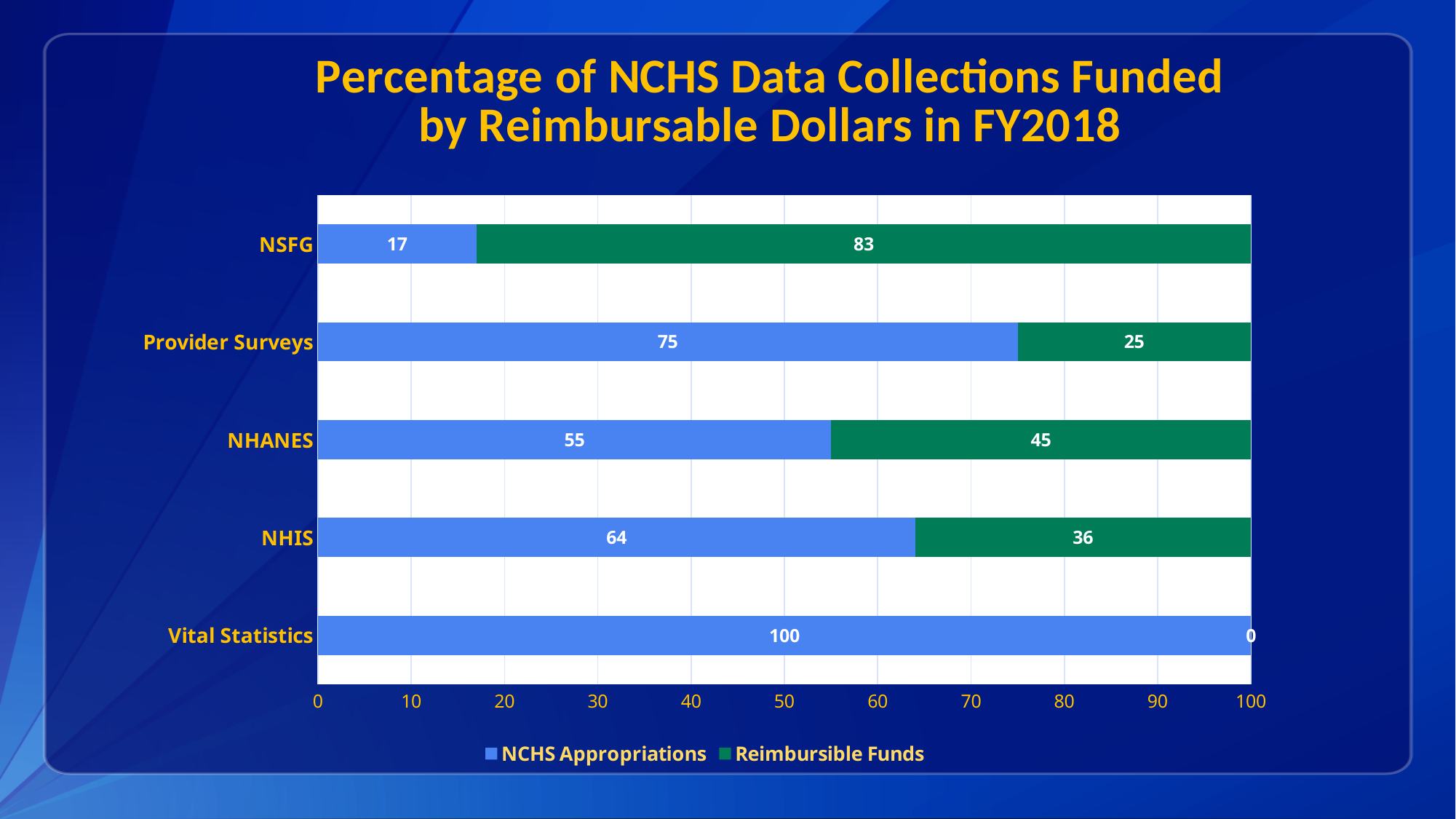
Which is larger, the Reimbursible Funds value for NHIS or for NHANES? NHANES How many series does the legend list? 2 What is the difference between the NCHS Appropriations values for Provider Surveys and NHANES? 20 What is the total of the stacked bar for Vital Statistics? 100 What kind of chart is shown on the slide? Stacked bar chart What is the NCHS Appropriations value for NSFG? 17 How many categories are shown on the chart? 5 What is the NCHS Appropriations value for NHIS? 64 Which category has the lowest NCHS Appropriations value? NSFG What is the Reimbursible Funds value for Provider Surveys? 25 What is the Reimbursible Funds value for NHANES? 45 Which category has the highest Reimbursible Funds value? NSFG